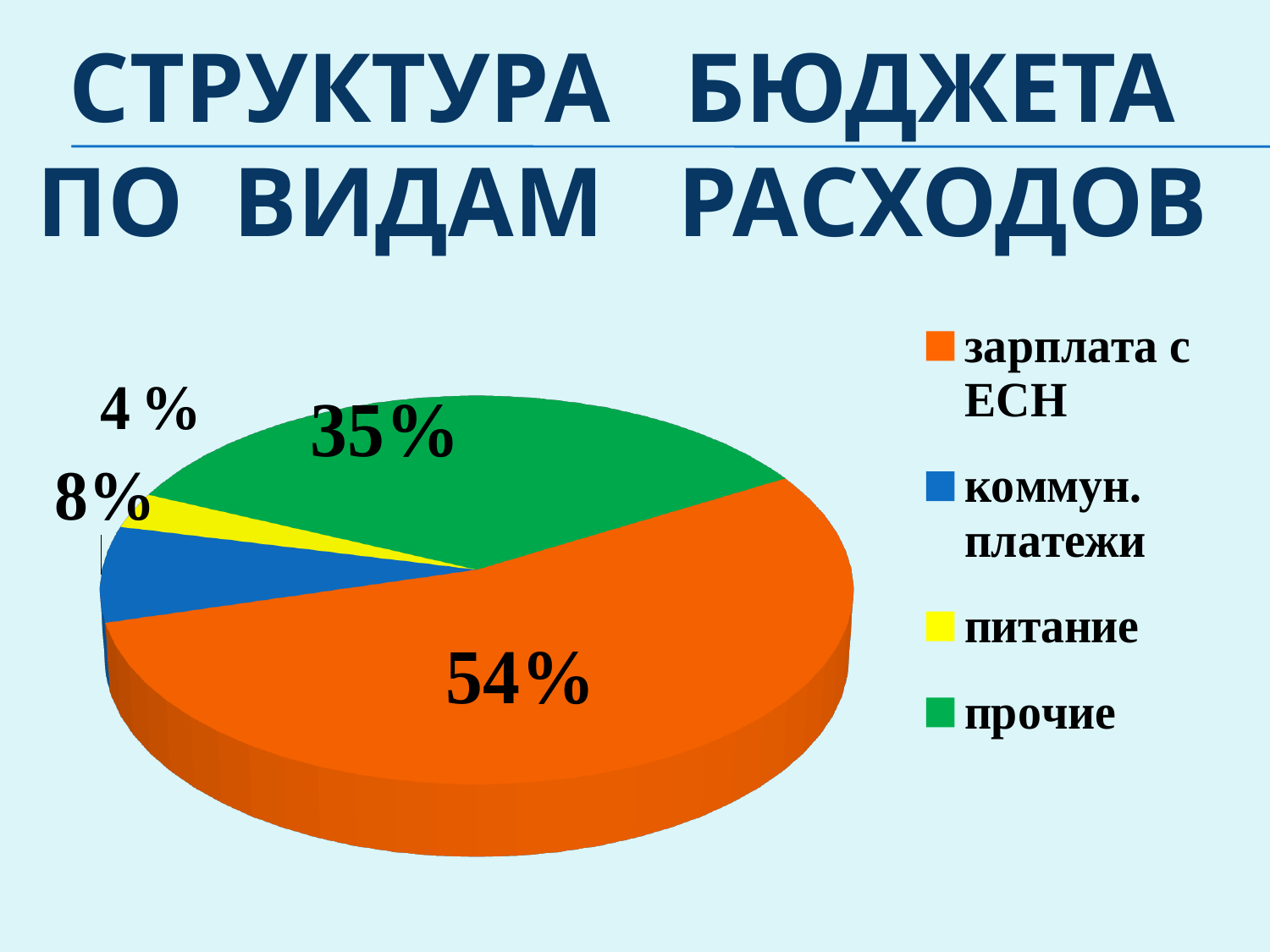
Which colour represents питание in the legend? yellow Which category has the largest share of the budget? зарплата с ЕСН What share of the budget goes to прочие? 35% Which is larger, the share for прочие or the share for коммун. платежи? прочие What kind of chart is shown on the slide? pie chart What is the difference between the share for коммун. платежи and the share for питание? 4% What share of the budget goes to зарплата с ЕСН? 54% Which category has the smallest share of the budget? питание What is the difference between the share for зарплата с ЕСН and the share for прочие? 19% What share of the budget goes to питание? 4 % How many categories does the pie chart show? 4